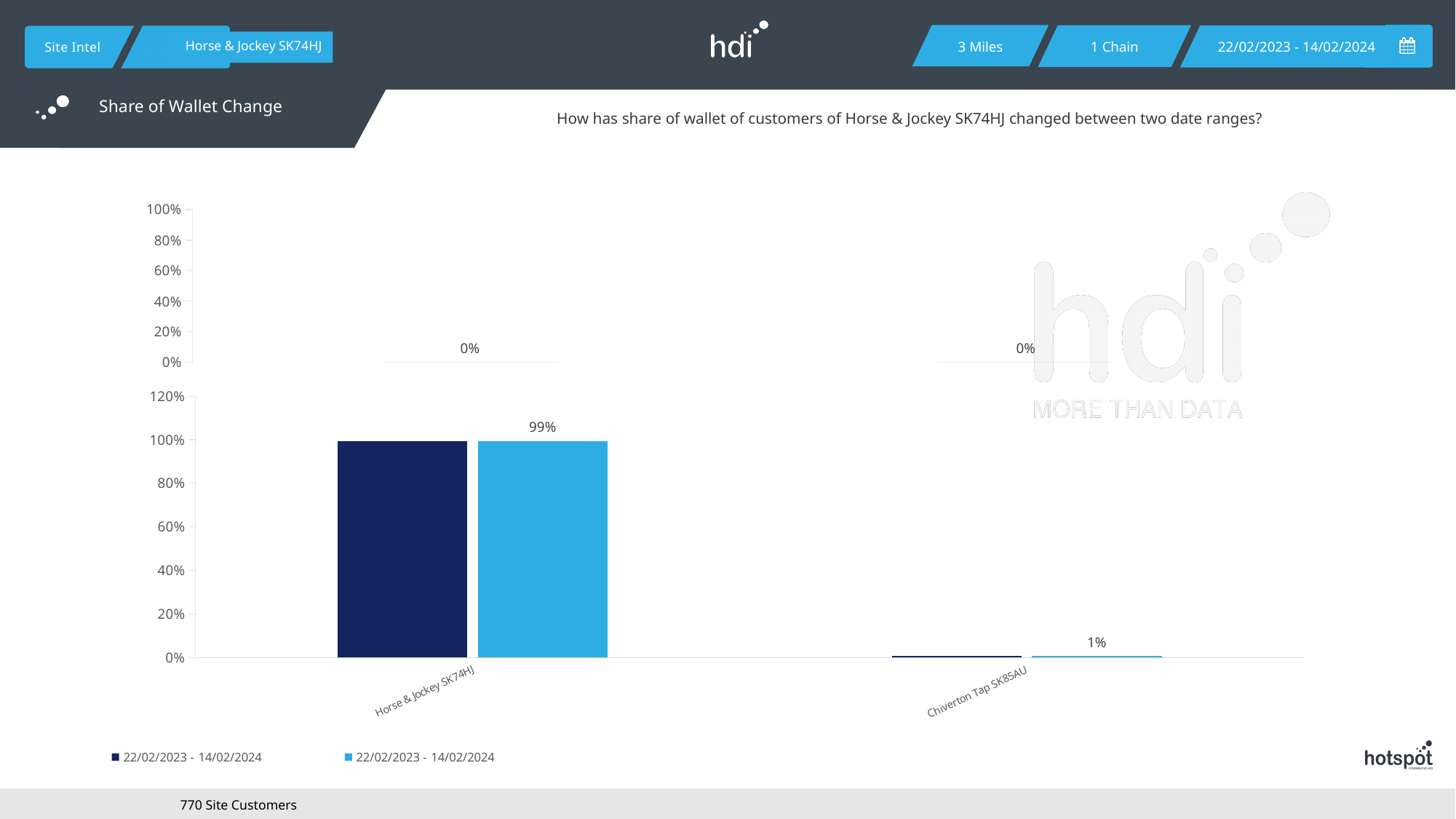
How many categories are shown on the x axis of the bottom chart? 2 How many series does the legend of the bottom chart list? 2 In the bottom chart, which category has the highest share of wallet? Horse & Jockey SK74HJ In the bottom chart, what is the labelled share of wallet for Chiverton Tap SK85AU? 1% In the top chart, what is the labelled change value for Horse & Jockey SK74HJ? 0% In the bottom chart, which category has the lowest share of wallet? Chiverton Tap SK85AU In the bottom chart, is the value for Horse & Jockey SK74HJ greater or less than 80%? greater In the bottom chart, is the value for Chiverton Tap SK85AU greater or less than 20%? less In the top chart, what is the labelled change value for Chiverton Tap SK85AU? 0% In the bottom chart, what is the labelled share of wallet for Horse & Jockey SK74HJ? 99% What kind of chart is the bottom chart? Bar chart In the bottom chart, what is the difference between the labelled values for Horse & Jockey SK74HJ and Chiverton Tap SK85AU? 98%